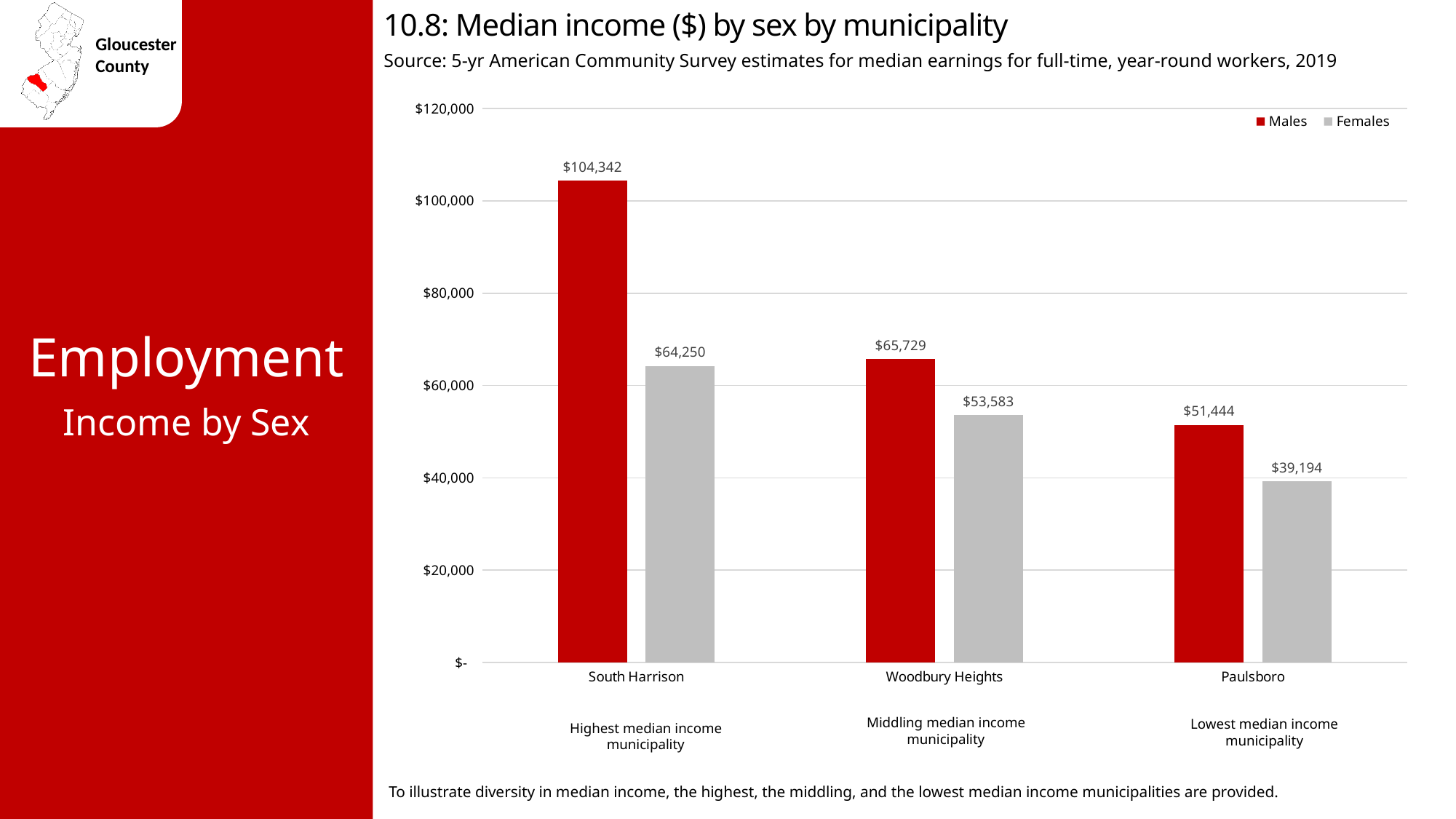
What is the median income for females in Paulsboro? $39,194 Is the male median income in Paulsboro greater or less than $60,000? less Which municipality has the lowest median income for females? Paulsboro What is the median income for males in South Harrison? $104,342 What is the difference between male and female median income in South Harrison? $40,092 What kind of chart is shown on the slide? Bar chart Which municipality has the highest median income for males? South Harrison Which is larger: the female median income in South Harrison or the male median income in Woodbury Heights? Male median income in Woodbury Heights What is the median income for females in Woodbury Heights? $53,583 How many municipalities are shown on the chart? 3 What is the difference between male and female median income in Paulsboro? $12,250 How many series does the legend list? 2